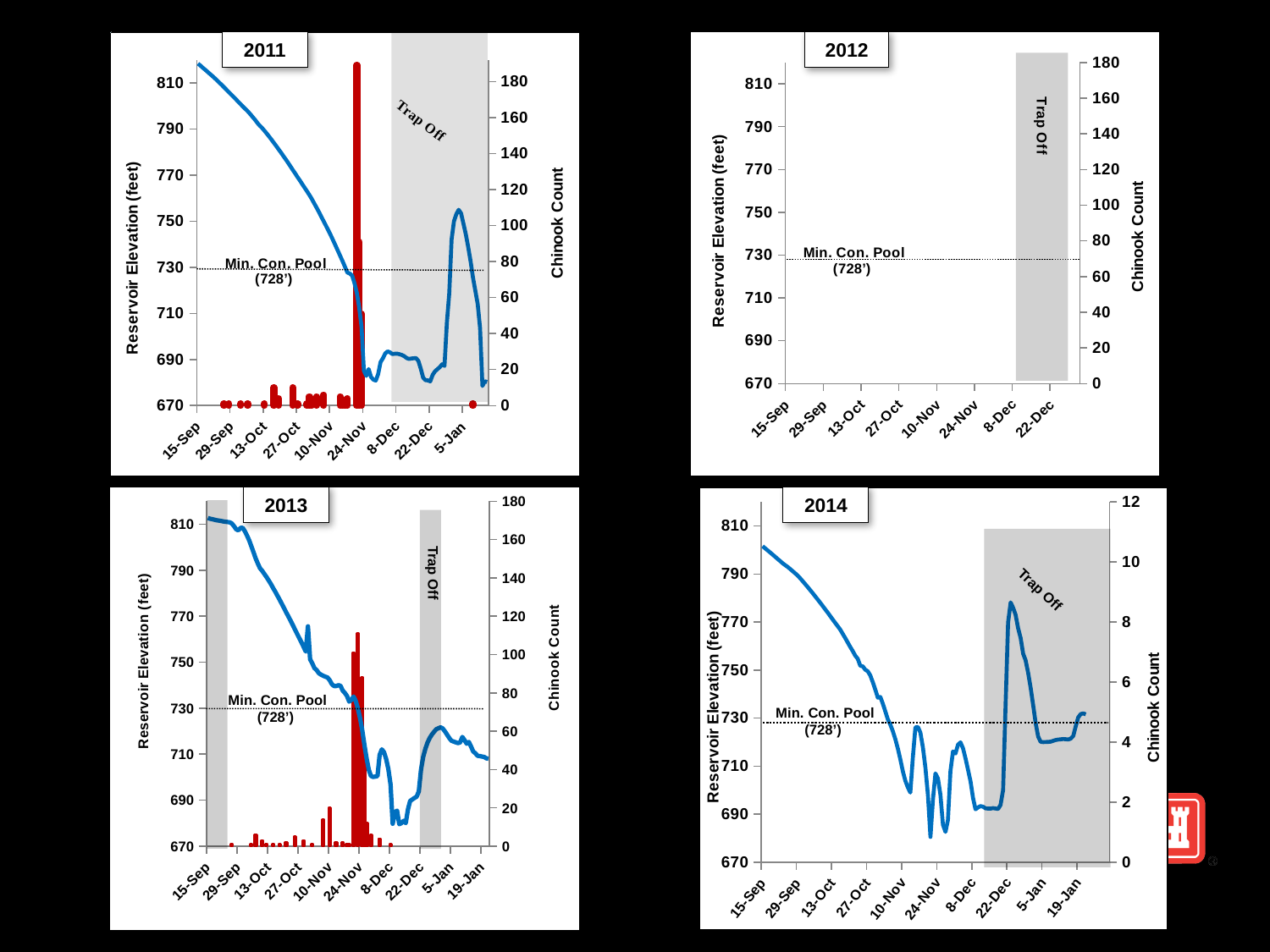
On the 2011 chart, is the tallest Chinook Count bar greater or less than 160? greater What is the label of the right-hand axis on the 2013 chart? Chinook Count On the 2011 chart, what elevation is labelled as the Min. Con. Pool? 728' On the 2014 chart, is the reservoir elevation at 15-Sep greater or less than 810 feet? less Which year's chart has no data plotted? 2012 On the 2014 chart, what is the maximum value shown on the right-hand Chinook Count axis? 12 On the 2011 chart, does the reservoir elevation rise or fall from 15-Sep to 24-Nov? Fall How many charts are on the slide? 4 On the 2014 chart, is the peak reservoir elevation in late December greater or less than 770 feet? greater What kind of chart is the 2011 chart? A combined line and bar chart